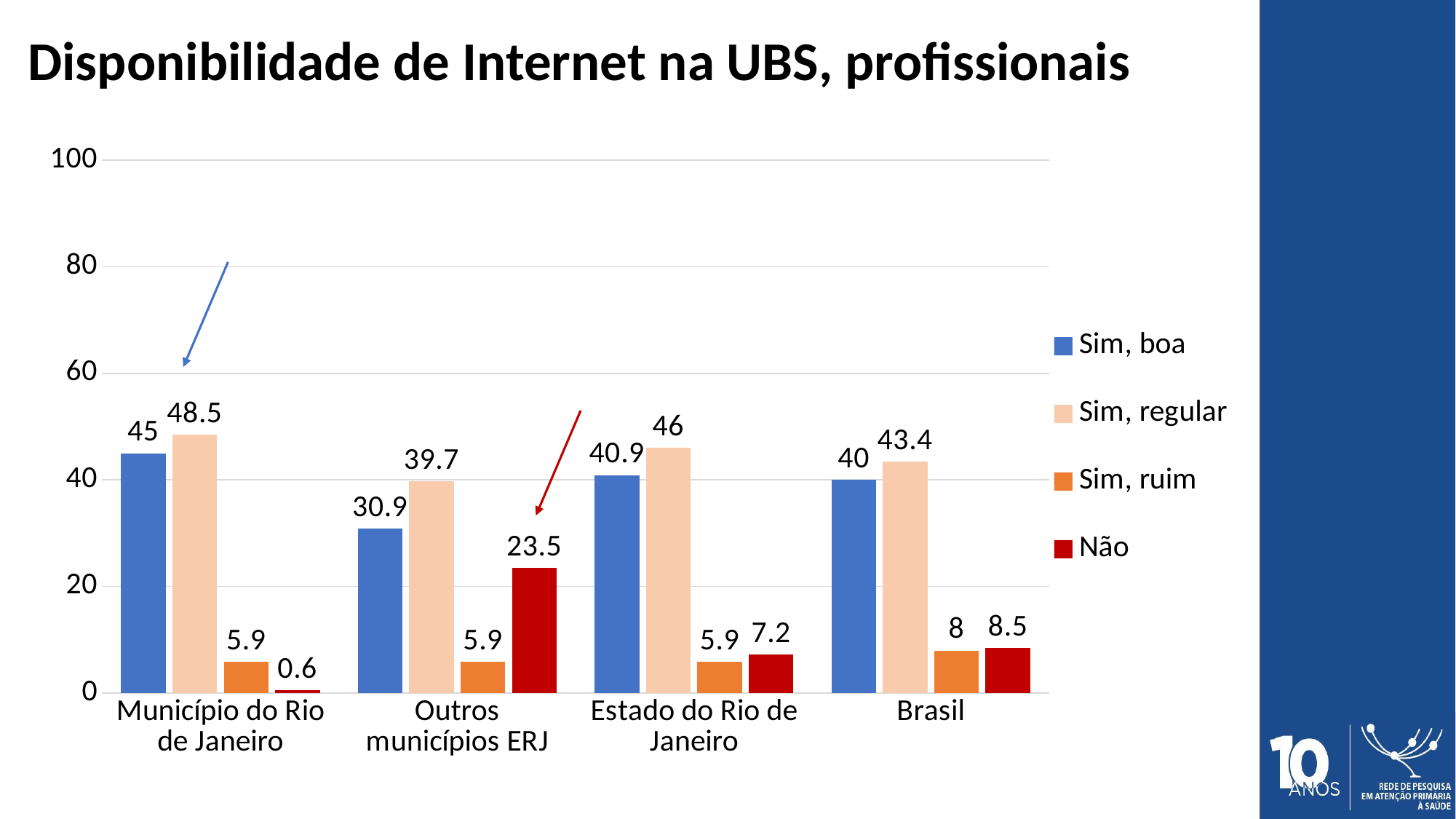
Which is larger in Brasil: "Sim, ruim" or "Não"? Não What kind of chart is shown on the slide? bar chart What is the value for "Não" in Outros municípios ERJ? 23.5 Which category has the highest value for "Não"? Outros municípios ERJ How many series does the legend list? 4 Which category has the lowest value for "Sim, boa"? Outros municípios ERJ Is the value for "Sim, regular" in Outros municípios ERJ greater or less than 40? less What is the value for "Sim, regular" in Município do Rio de Janeiro? 48.5 How many categories are shown on the x axis? 4 What is the difference between "Sim, regular" and "Sim, boa" in Estado do Rio de Janeiro? 5.1 What is the value for "Sim, boa" in Brasil? 40 What is the title of the slide? Disponibilidade de Internet na UBS, profissionais